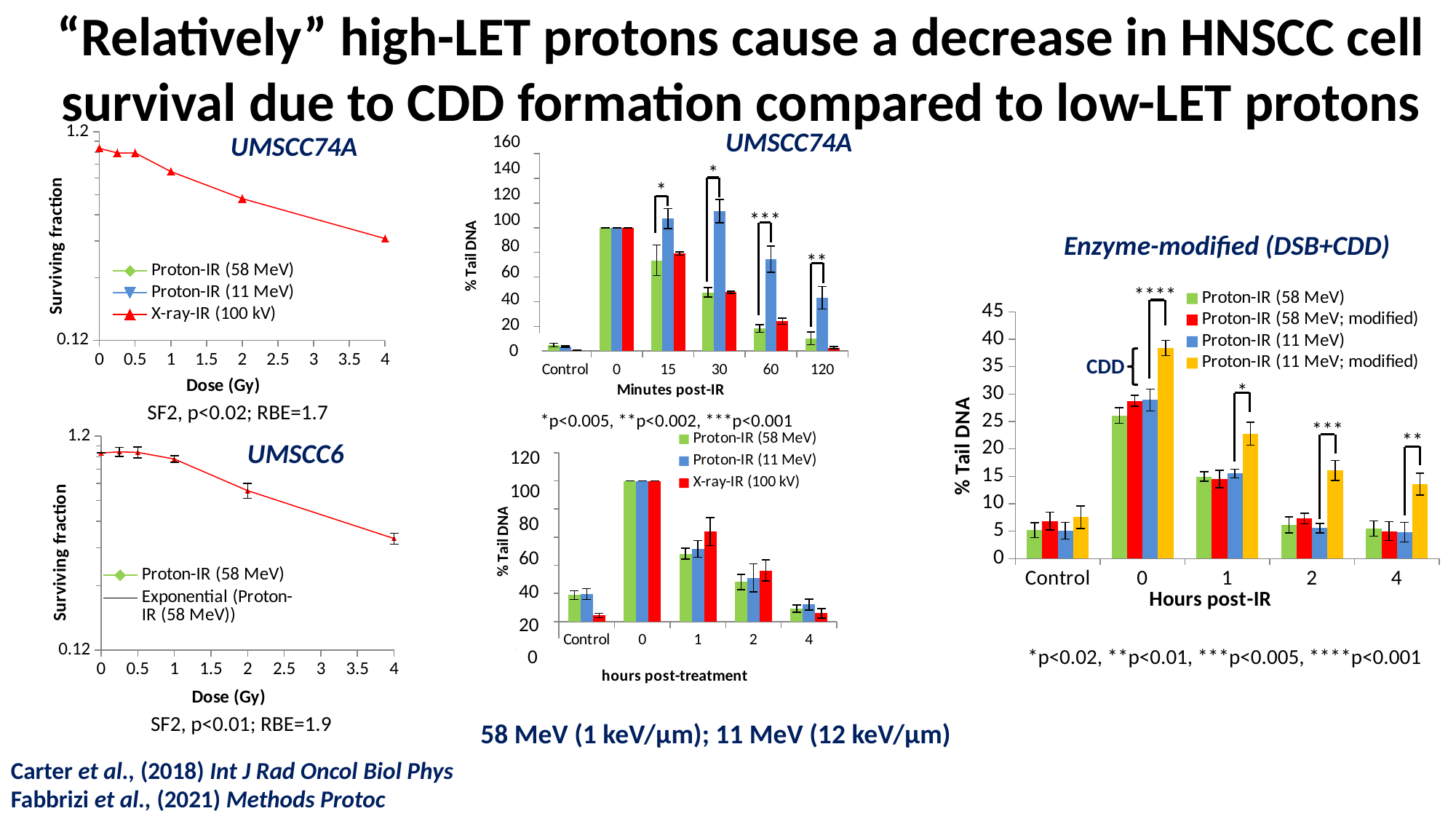
In the top-middle UMSCC74A % Tail DNA bar chart, is the value for X-ray-IR (100 kV) at 120 minutes greater or less than 20? less In the top-middle UMSCC74A % Tail DNA bar chart, how many categories are shown on the Minutes post-IR axis? 6 In the 'Enzyme-modified (DSB+CDD)' chart, is the value for Proton-IR (11 MeV; modified) at 0 hours greater or less than 30? greater In the 'Enzyme-modified (DSB+CDD)' chart, how many series does the legend list? 4 What kind of chart is the 'Enzyme-modified (DSB+CDD)' chart on the right of the slide? bar chart In the bottom-middle % Tail DNA bar chart, is the value for Proton-IR (58 MeV) at 0 hours post-treatment greater or less than 80? greater In the 'Enzyme-modified (DSB+CDD)' chart, how many categories are shown on the Hours post-IR axis? 5 In the top-left UMSCC74A surviving fraction chart, does the X-ray-IR (100 kV) line rise or fall as dose increases? fall In the bottom-left UMSCC6 surviving fraction chart, how many entries does the legend list? 2 In the top-middle UMSCC74A % Tail DNA bar chart, at 30 minutes post-IR, which is larger: Proton-IR (11 MeV) or X-ray-IR (100 kV)? Proton-IR (11 MeV) In the 'Enzyme-modified (DSB+CDD)' chart, at 4 hours post-IR, which is larger: Proton-IR (11 MeV; modified) or Proton-IR (58 MeV)? Proton-IR (11 MeV; modified)